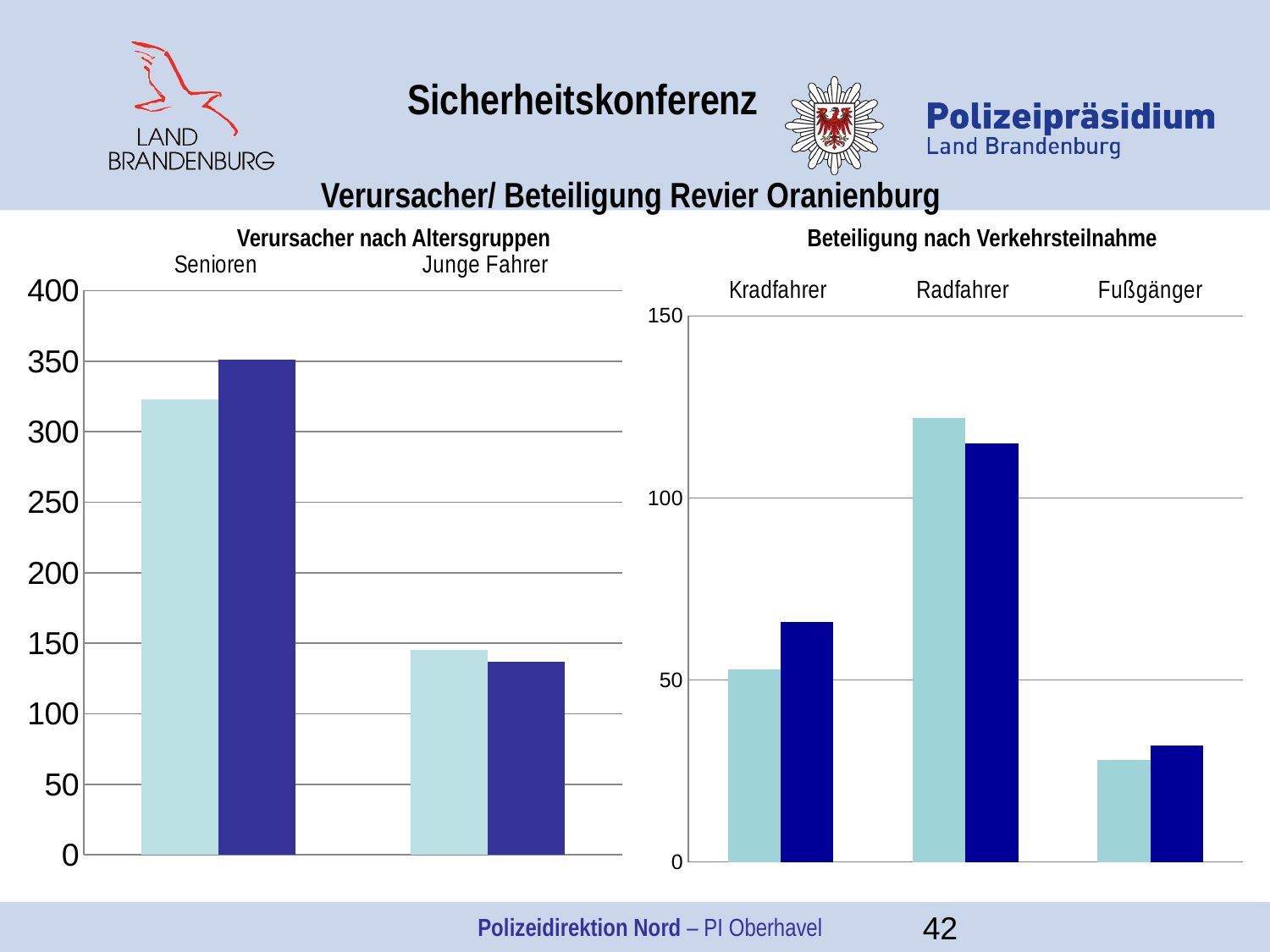
What is the title of the chart on the right side of the slide? Beteiligung nach Verkehrsteilnahme In the 'Beteiligung nach Verkehrsteilnahme' chart, is the dark blue bar for Fußgänger greater or less than 50? less In the 'Verursacher nach Altersgruppen' chart, is the light blue bar for Senioren greater or less than 300? greater In the 'Beteiligung nach Verkehrsteilnahme' chart, which category has the lowest bars? Fußgänger In the 'Verursacher nach Altersgruppen' chart, which category has the highest bars? Senioren In the 'Verursacher nach Altersgruppen' chart, is the dark blue bar for Junge Fahrer greater or less than 150? less What kind of chart is the 'Verursacher nach Altersgruppen' chart on the left? bar chart How many categories are shown on the x axis of the 'Beteiligung nach Verkehrsteilnahme' chart on the right? 3 How many categories are shown on the x axis of the 'Verursacher nach Altersgruppen' chart on the left? 2 In the 'Beteiligung nach Verkehrsteilnahme' chart, which category has the highest bars? Radfahrer In the 'Beteiligung nach Verkehrsteilnahme' chart, which is larger for Kradfahrer: the light blue bar or the dark blue bar? the dark blue bar